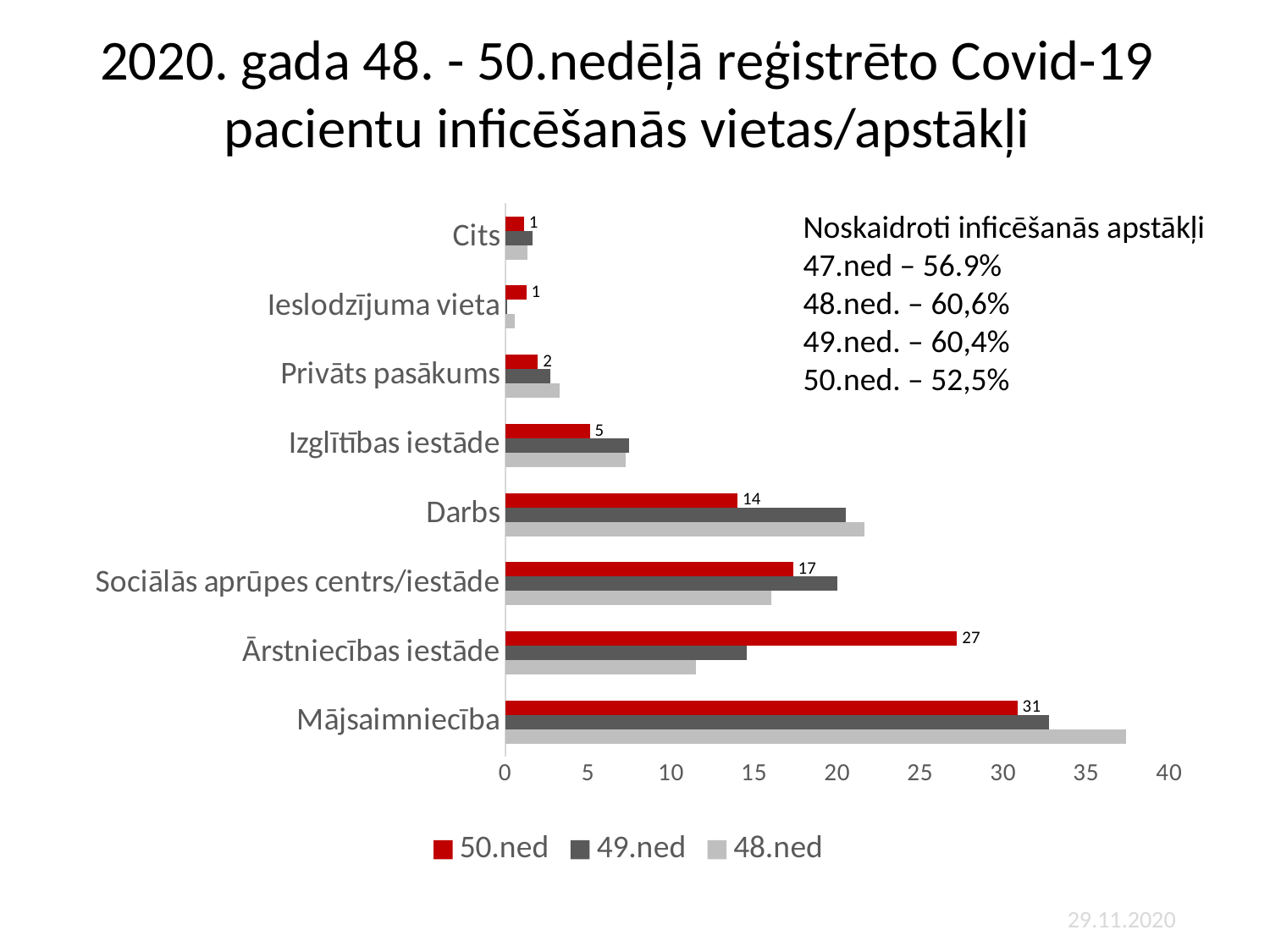
What is the value for Ārstniecības iestāde in the 50.ned series? 27 Which category has the highest value in the 50.ned series? Mājsaimniecība What is the value for Mājsaimniecība in the 50.ned series? 31 How many categories are shown on the chart? 8 Which series is shown in red in the legend? 50.ned What is the difference between the 50.ned values for Mājsaimniecība and Ārstniecības iestāde? 4 Is the 48.ned value for Mājsaimniecība greater or less than 35? greater In the 50.ned series, which is larger: Sociālās aprūpes centrs/iestāde or Darbs? Sociālās aprūpes centrs/iestāde Is the 48.ned value for Ārstniecības iestāde greater or less than 10? greater How many series does the legend list? 3 What is the value for Darbs in the 50.ned series? 14 What kind of chart is shown on the slide? bar chart